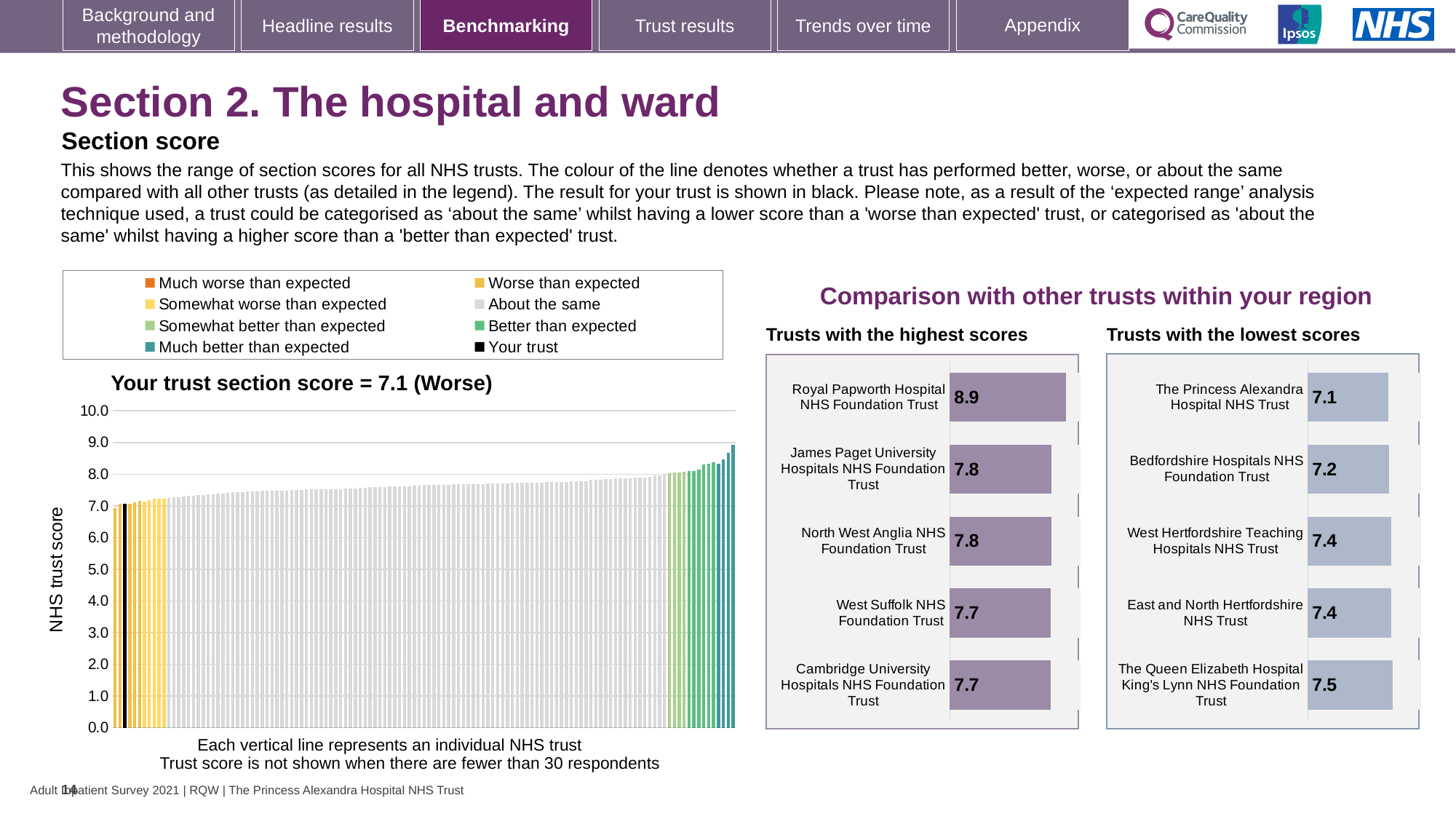
In the 'Trusts with the lowest scores' chart, which trust has the lowest score? The Princess Alexandra Hospital NHS Trust In the 'Trusts with the highest scores' chart, what is the score for Royal Papworth Hospital NHS Foundation Trust? 8.9 In the 'Trusts with the highest scores' chart, which trust has the highest score? Royal Papworth Hospital NHS Foundation Trust In the chart titled 'Your trust section score = 7.1 (Worse)', do the trust scores rise or fall from left to right? Rise In the 'Trusts with the lowest scores' chart, which trust has the highest score? The Queen Elizabeth Hospital King's Lynn NHS Foundation Trust How many entries does the legend above the 'Your trust section score = 7.1 (Worse)' chart list? 8 In the 'Trusts with the highest scores' chart, what is the difference between the scores of Royal Papworth Hospital NHS Foundation Trust and West Suffolk NHS Foundation Trust? 1.2 In the 'Trusts with the highest scores' chart, how many trusts are shown? 5 In the 'Trusts with the lowest scores' chart, what is the difference between the scores of The Queen Elizabeth Hospital King's Lynn NHS Foundation Trust and The Princess Alexandra Hospital NHS Trust? 0.4 In the 'Trusts with the lowest scores' chart, what is the score for Bedfordshire Hospitals NHS Foundation Trust? 7.2 In the chart titled 'Your trust section score = 7.1 (Worse)', what kind of chart is it? Bar chart In the 'Trusts with the lowest scores' chart, which has the larger score: Bedfordshire Hospitals NHS Foundation Trust or West Hertfordshire Teaching Hospitals NHS Trust? West Hertfordshire Teaching Hospitals NHS Trust